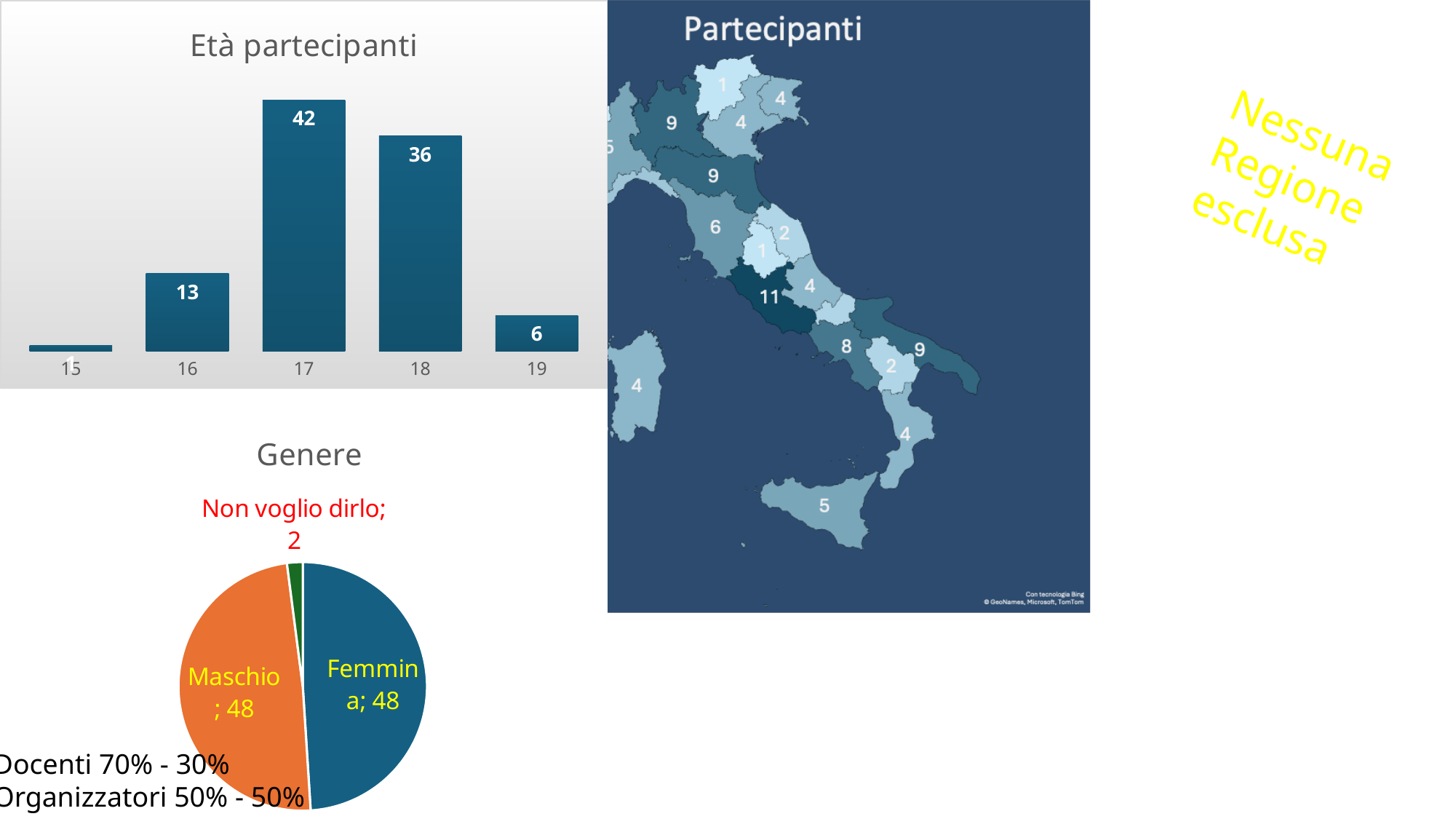
In the 'Età partecipanti' chart, which is larger, the value for age 16 or for age 19? 16 In the 'Età partecipanti' chart, which age has the highest value? 17 What kind of chart is 'Età partecipanti'? bar chart In the 'Età partecipanti' chart, what is the value for age 18? 36 In the 'Età partecipanti' chart, what is the difference between the values for age 17 and age 18? 6 In the 'Età partecipanti' chart, which age has the lowest value? 15 How many age categories are shown in the 'Età partecipanti' chart? 5 In the 'Età partecipanti' chart, what is the value for age 16? 13 In the 'Genere' pie chart, what is the value for 'Non voglio dirlo'? 2 How many slices does the 'Genere' pie chart have? 3 In the 'Genere' pie chart, what is the value for 'Femmina'? 48 In the 'Età partecipanti' chart, what is the value for age 17? 42